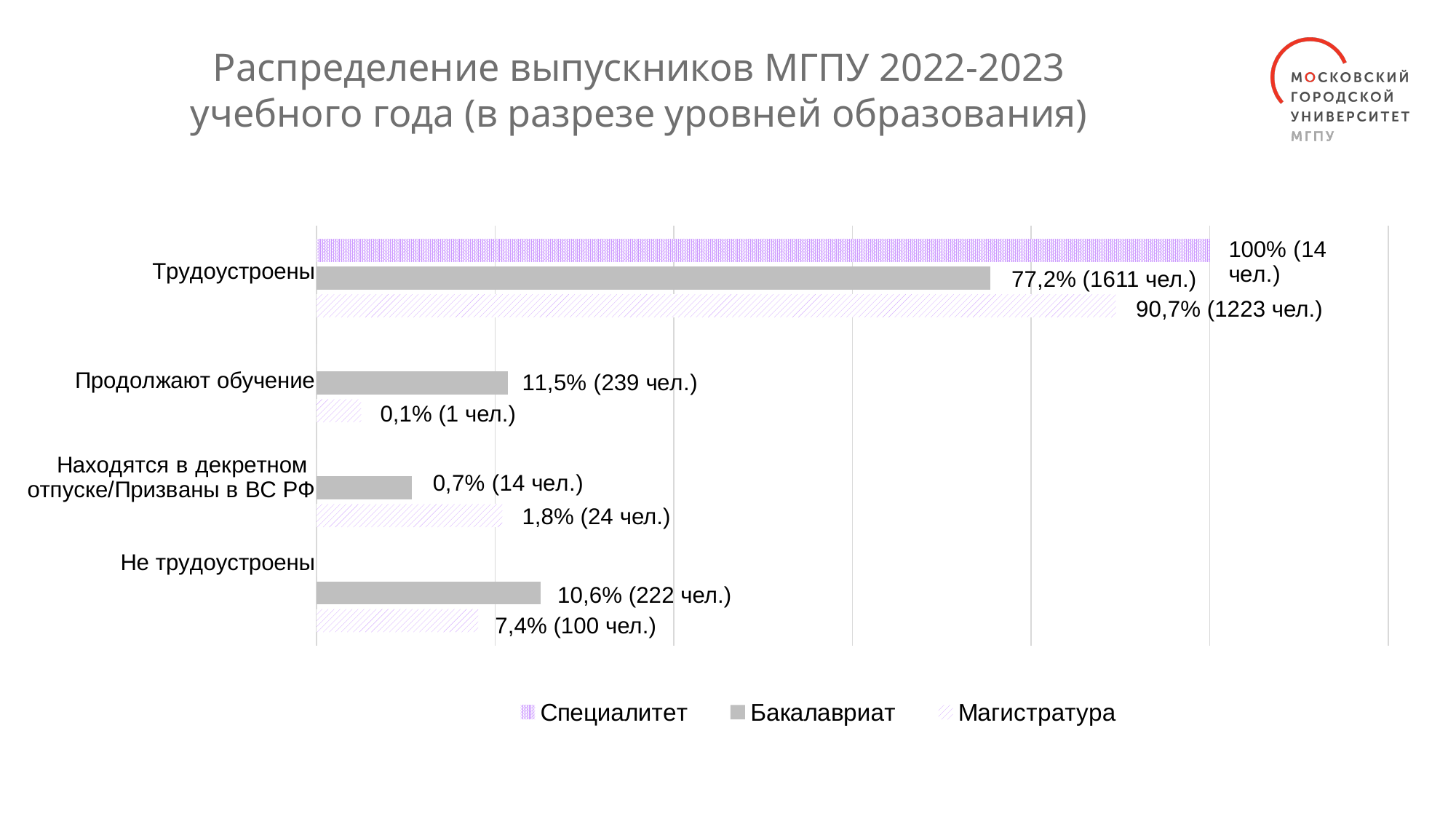
What is the value for Бакалавриат in the category Не трудоустроены? 10,6% (222 чел.) How many categories are shown on the vertical axis of the chart? 4 Which series has the highest percentage in the category Трудоустроены? Специалитет What is the value for Специалитет in the category Трудоустроены? 100% (14 чел.) Which is larger in the category Не трудоустроены: the value for Бакалавриат or for Магистратура? Бакалавриат How many series does the legend list? 3 What is the value for Магистратура in the category Трудоустроены? 90,7% (1223 чел.) What is the value for Магистратура in the category Продолжают обучение? 0,1% (1 чел.) What is the difference in percentage points between Магистратура and Бакалавриат in the category Трудоустроены? 13,5 What is the value for Бакалавриат in the category Трудоустроены? 77,2% (1611 чел.) What kind of chart is shown on the slide? bar chart